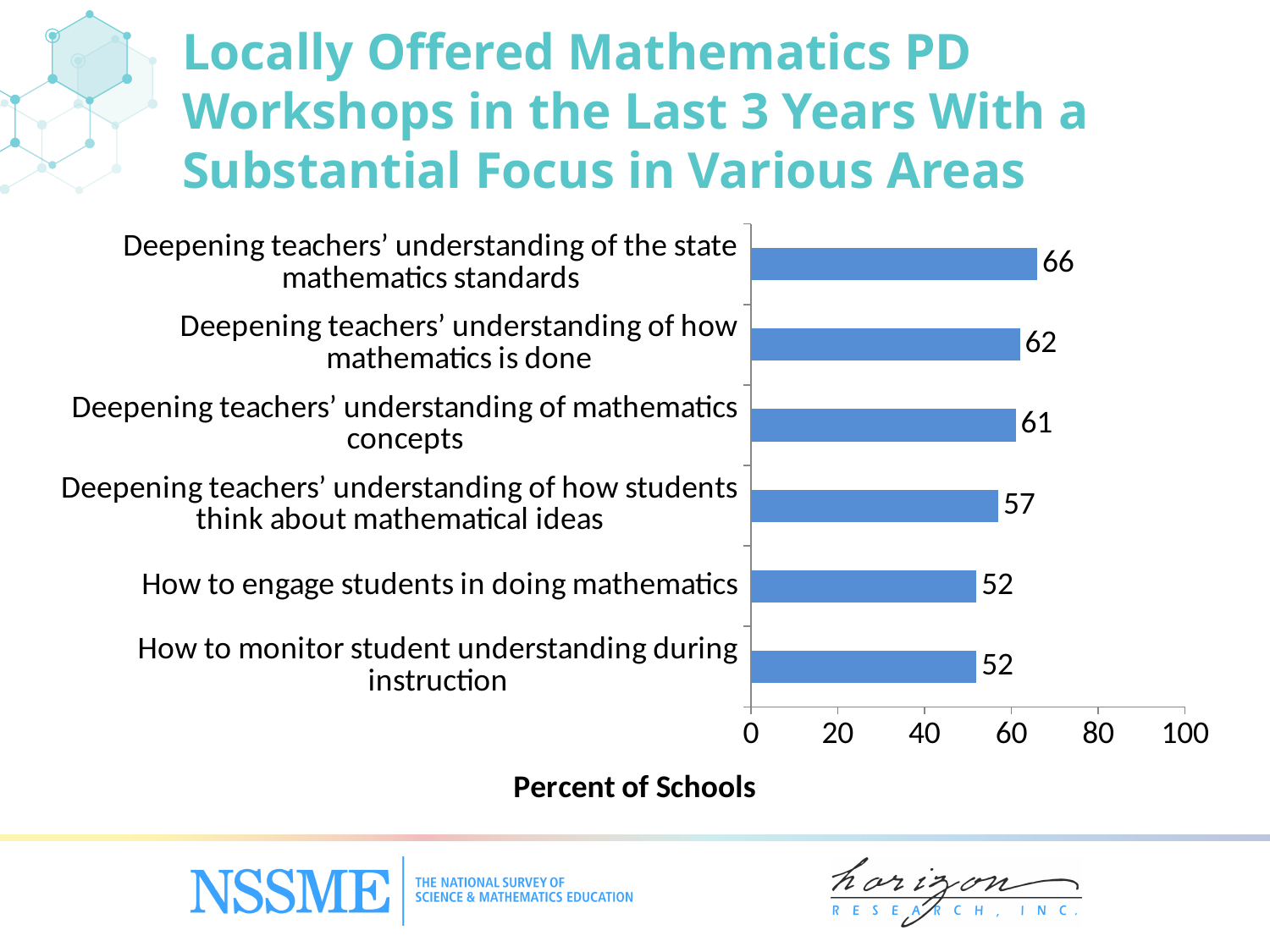
What is the difference between the values for 'Deepening teachers' understanding of the state mathematics standards' and 'How to monitor student understanding during instruction'? 14 What is the difference between the values for 'Deepening teachers' understanding of how mathematics is done' and 'Deepening teachers' understanding of mathematics concepts'? 1 Which category has the highest percent of schools? Deepening teachers' understanding of the state mathematics standards Is the value for 'Deepening teachers' understanding of how students think about mathematical ideas' greater or less than 60? less What kind of chart is shown on the slide? bar chart How many categories are shown in the chart? 6 What percent of schools reported locally offered PD workshops with a substantial focus on deepening teachers' understanding of the state mathematics standards? 66 What is the maximum value shown on the horizontal axis? 100 What is the label of the horizontal axis? Percent of Schools What is the value for 'How to engage students in doing mathematics'? 52 Which is larger: the value for 'Deepening teachers' understanding of how mathematics is done' or the value for 'How to engage students in doing mathematics'? Deepening teachers' understanding of how mathematics is done What is the value for 'Deepening teachers' understanding of how students think about mathematical ideas'? 57